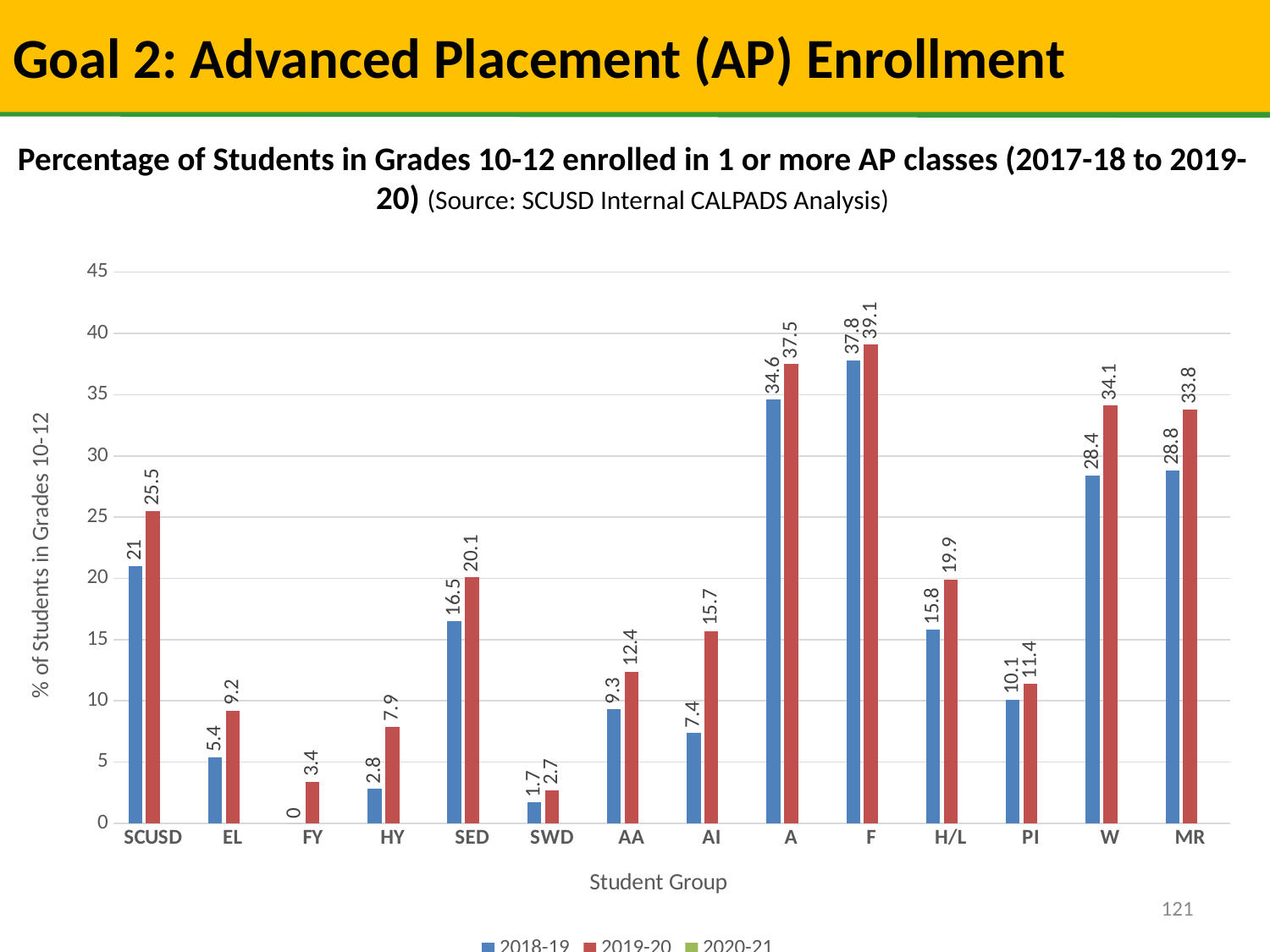
Is the 2018-19 value for A greater or less than 30? greater Which student group has the highest value in the 2019-20 series? F What is the label of the y axis? % of Students in Grades 10-12 What is the value for FY in the 2018-19 series? 0 What is the value for F in the 2018-19 series? 37.8 Which is larger, the 2019-20 value for W or the 2019-20 value for MR? W How many series does the legend list? 3 What kind of chart is shown on the slide? bar chart How many student groups are shown on the x axis? 14 Which student group has the lowest value in the 2019-20 series? SWD What is the difference between the 2019-20 and 2018-19 values for H/L? 4.1 What is the value for SCUSD in the 2019-20 series? 25.5